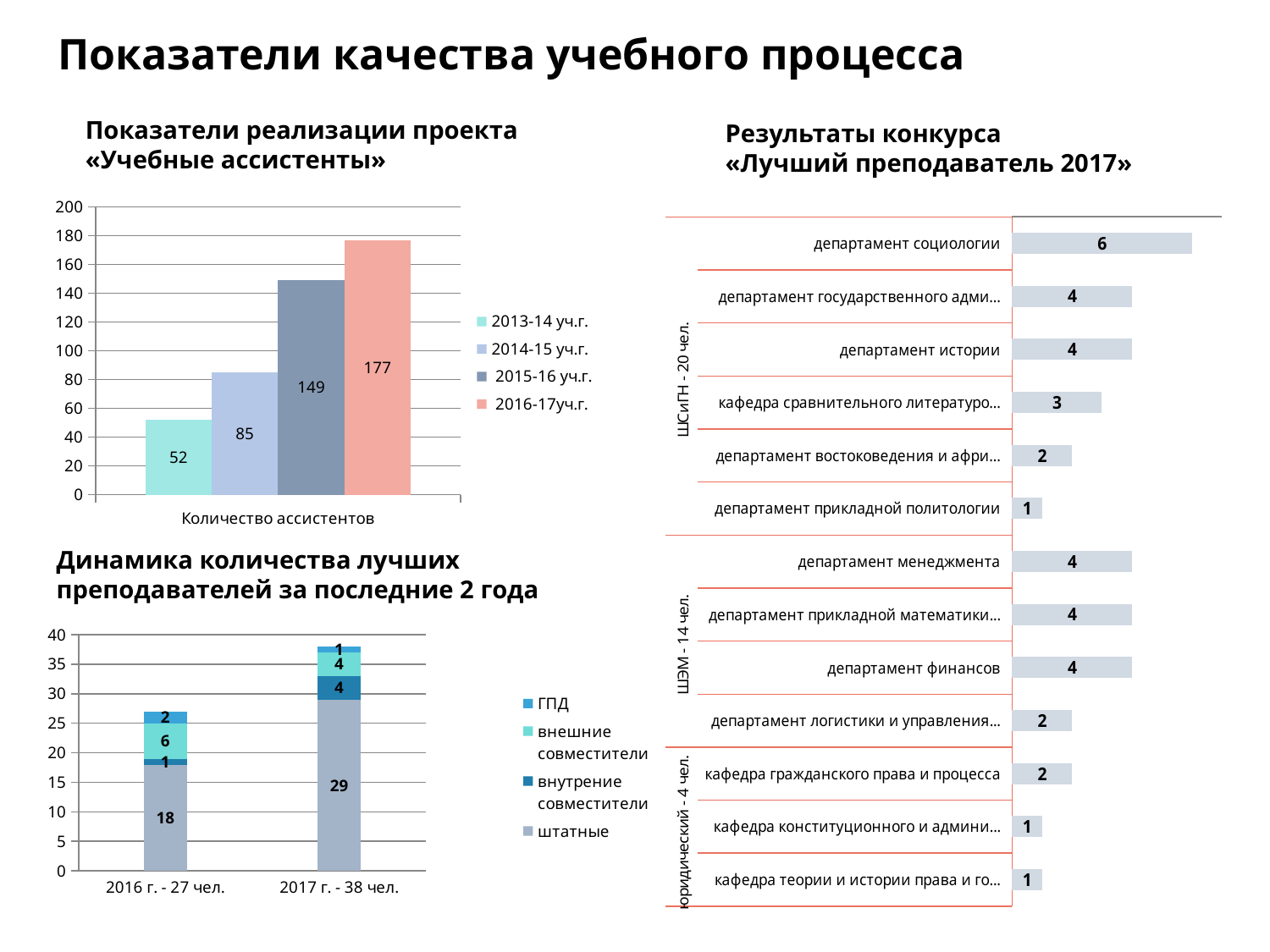
In the chart «Динамика количества лучших преподавателей за последние 2 года», which is larger: внешние совместители in 2016 г. - 27 чел. or in 2017 г. - 38 чел.? 2016 г. - 27 чел. In the chart «Показатели реализации проекта «Учебные ассистенты»», which series has the highest value? 2016-17уч.г. In the chart «Результаты конкурса «Лучший преподаватель 2017»», how many categories are plotted? 13 In the chart «Динамика количества лучших преподавателей за последние 2 года», what is the total of the stacked bar for 2016 г. - 27 чел.? 27 In the chart «Показатели реализации проекта «Учебные ассистенты»», how many series does the legend list? 4 In the chart «Показатели реализации проекта «Учебные ассистенты»», what is the difference between the 2016-17уч.г. value and the 2013-14 уч.г. value? 125 In the chart «Результаты конкурса «Лучший преподаватель 2017»», what is the value for департамент социологии? 6 In the chart «Показатели реализации проекта «Учебные ассистенты»», do the values rise or fall from 2013-14 уч.г. to 2016-17уч.г.? rise In the chart «Результаты конкурса «Лучший преподаватель 2017»», what is the difference between департамент финансов and департамент логистики и управления...? 2 In the chart «Динамика количества лучших преподавателей за последние 2 года», what is the value for штатные in 2017 г. - 38 чел.? 29 In the chart «Показатели реализации проекта «Учебные ассистенты»», what is the value for 2015-16 уч.г.? 149 What kind of chart is «Динамика количества лучших преподавателей за последние 2 года»? stacked bar chart